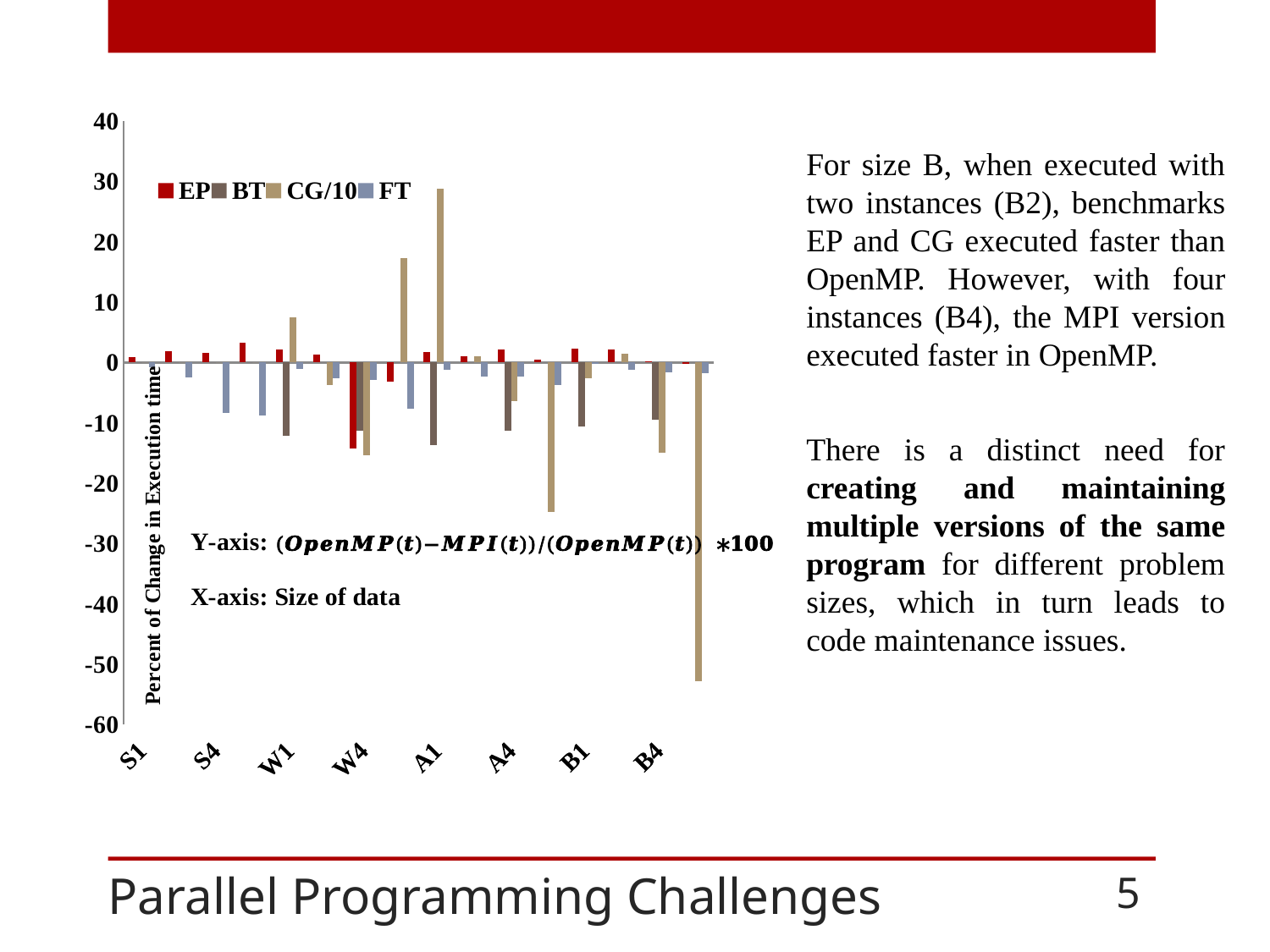
Which series has the lowest (most negative) value anywhere on the chart? CG/10 What is the highest tick value shown on the y-axis? 40 How many series does the chart legend list? 4 Is the value for CG/10 at B4 greater or less than -40? greater Which series has the highest value anywhere on the chart? CG/10 What kind of chart is shown on the slide? bar chart What are the series names listed in the chart legend? EP, BT, CG/10, FT What is the lowest tick value shown on the y-axis? -60 Is the value for CG/10 at B4 greater or less than -50? greater